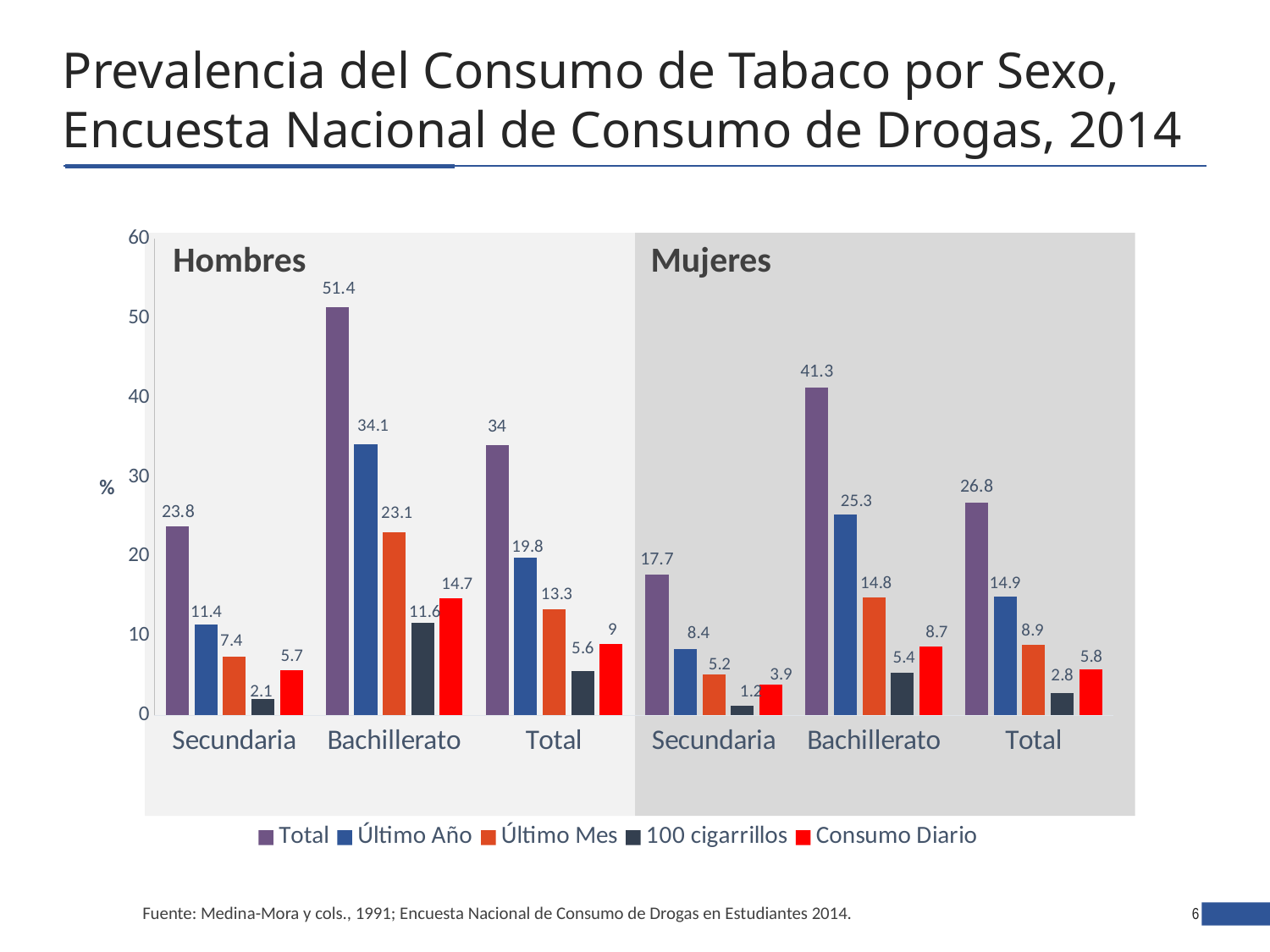
Which series has the lowest value for Bachillerato in the Hombres panel? 100 cigarrillos What are the two panel labels shown inside the chart area? Hombres and Mujeres How many series does the legend list? 5 Is the 'Total' series value for the Total category in the Mujeres panel greater or less than 30? less What type of chart is shown on the slide? bar chart What is the value of '100 cigarrillos' for Secundaria in the Mujeres panel? 1.2 What is the value of 'Último Año' for Secundaria in the Mujeres panel? 8.4 Which is larger: 'Último Mes' for Bachillerato in the Hombres panel or 'Último Mes' for Bachillerato in the Mujeres panel? Hombres What is the difference between the 'Total' series value for Bachillerato in the Hombres panel and in the Mujeres panel? 10.1 What is the value of 'Consumo Diario' for the Total category in the Hombres panel? 9 What is the value of the 'Total' series for Bachillerato in the Hombres panel? 51.4 Which category in the Mujeres panel has the highest 'Total' series value? Bachillerato